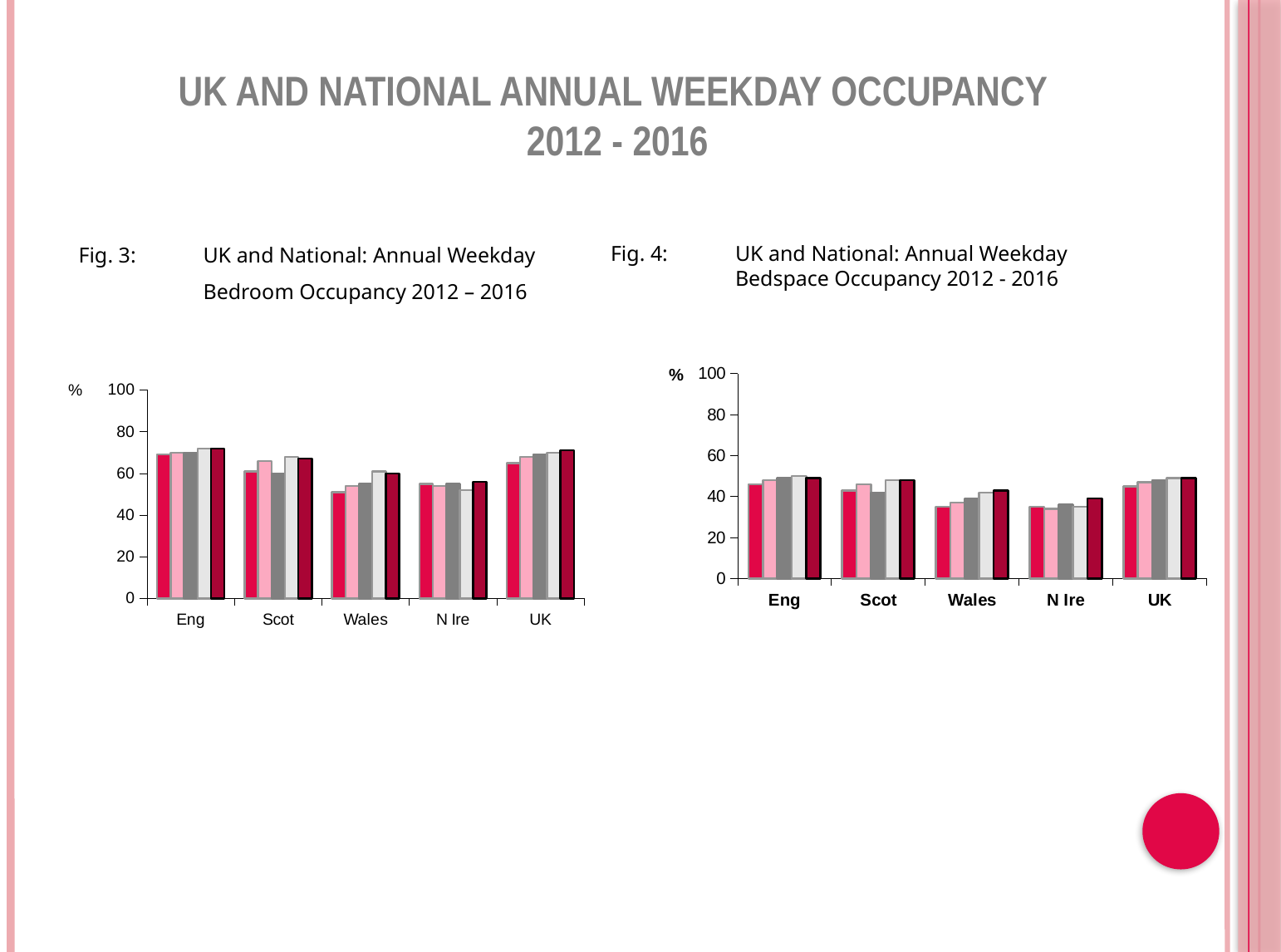
In Fig. 3, is the value of the first bar for Wales greater or less than 60? less In Fig. 4, is the value of the first bar for Eng greater or less than 40? greater In Fig. 4, which has the higher last bar, Eng or N Ire? Eng What kind of chart is Fig. 4 (UK and National: Annual Weekday Bedspace Occupancy 2012 - 2016)? bar chart In Fig. 3, is the value of the first bar for Eng greater or less than 60? greater In Fig. 3, how many categories are shown on the x axis? 5 In Fig. 3, which has the higher first bar, Eng or Wales? Eng In Fig. 3, how many bars are plotted for each category? 5 In Fig. 4, how many categories are shown on the x axis? 5 What kind of chart is Fig. 3 (UK and National: Annual Weekday Bedroom Occupancy 2012 – 2016)? bar chart What unit is shown on the y axis of Fig. 4? %